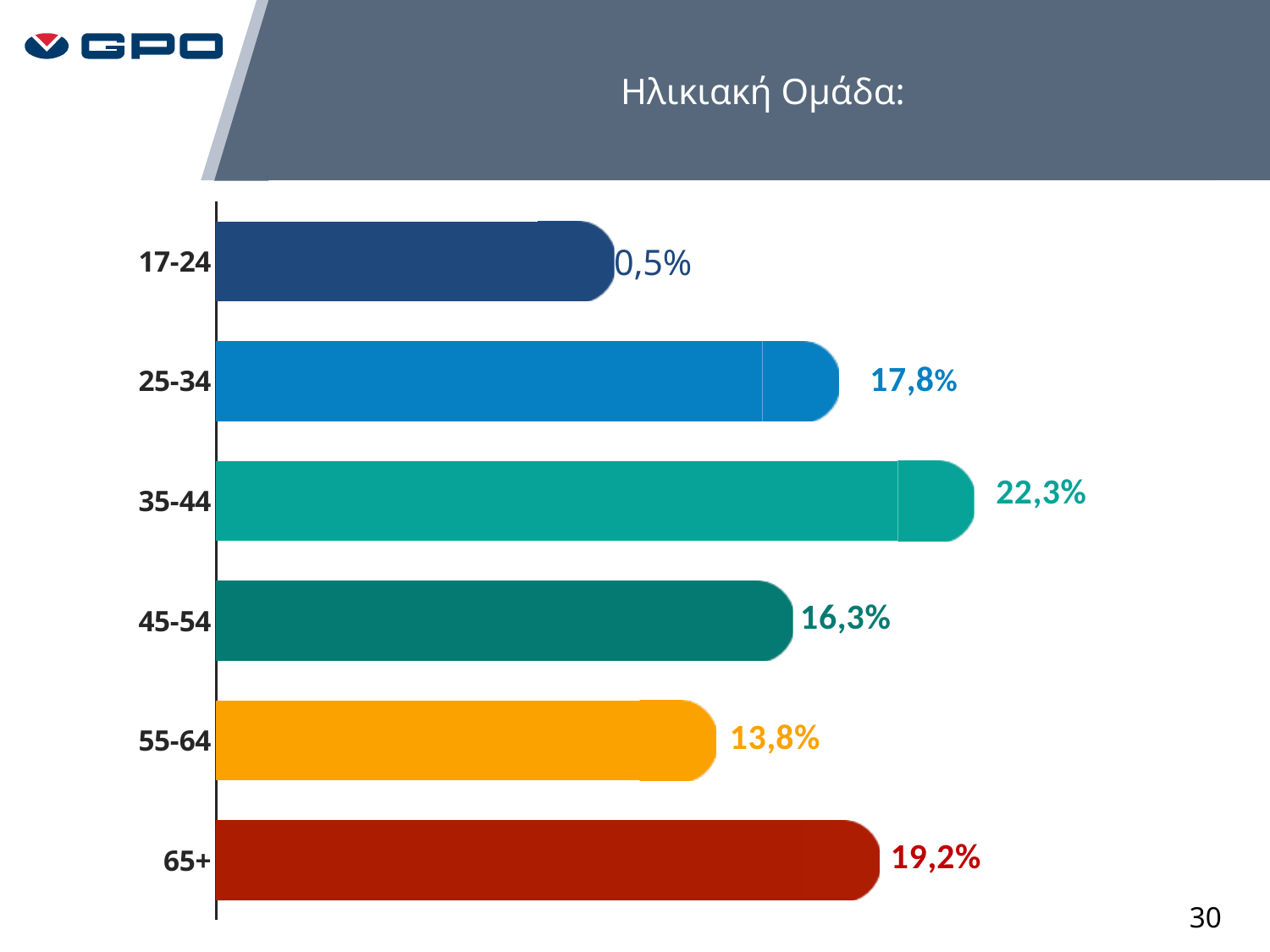
Which has the larger value, 25-34 or 45-54? 25-34 Which age group has the lowest value? 17-24 What is the value for the 65+ age group? 19,2% How many age groups are shown in the chart? 6 Which age group has the highest value? 35-44 What is the difference between the values for 35-44 and 65+? 3,1% What kind of chart is shown on the slide? bar chart What is the value for the 35-44 age group? 22,3% What is the value for the 55-64 age group? 13,8% What is the value for the 25-34 age group? 17,8% What is the title of the chart? Ηλικιακή Ομάδα: What is the value for the 45-54 age group? 16,3%